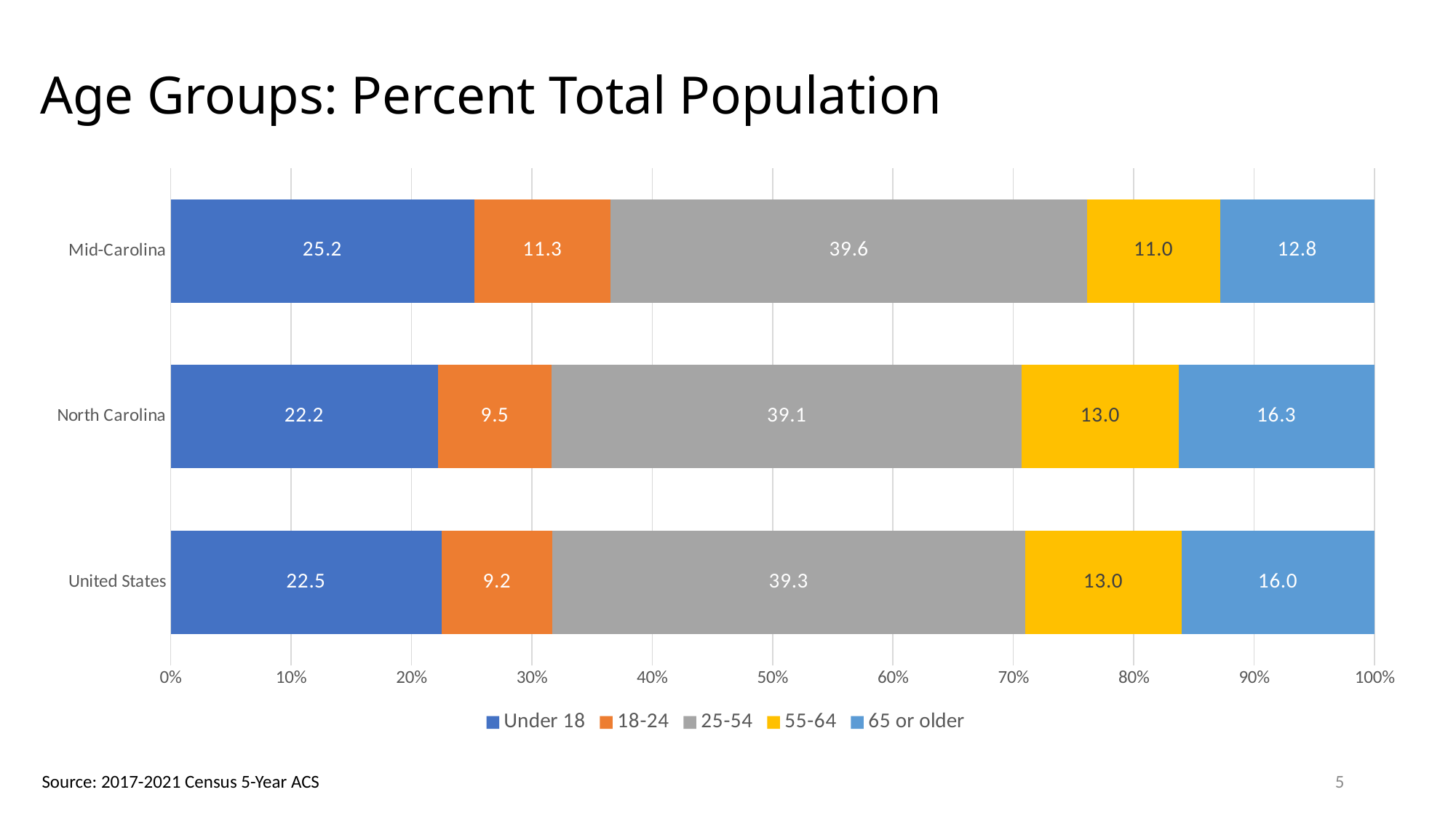
What is the value for the 18-24 age group in the United States? 9.2 How many regions are shown on the chart? 3 What kind of chart is shown on the slide? Stacked bar chart What is the difference between the Under 18 values for Mid-Carolina and North Carolina? 3.0 Which region has the highest value for the 25-54 age group? Mid-Carolina What is the title of the chart? Age Groups: Percent Total Population What is the value for the 65 or older age group in North Carolina? 16.3 What is the value for the Under 18 age group in Mid-Carolina? 25.2 How many age groups does the legend list? 5 Which region has the lowest value for the 65 or older age group? Mid-Carolina Which is larger: the 18-24 value for Mid-Carolina or for the United States? Mid-Carolina What is the total of the Under 18 and 18-24 segments for North Carolina? 31.7